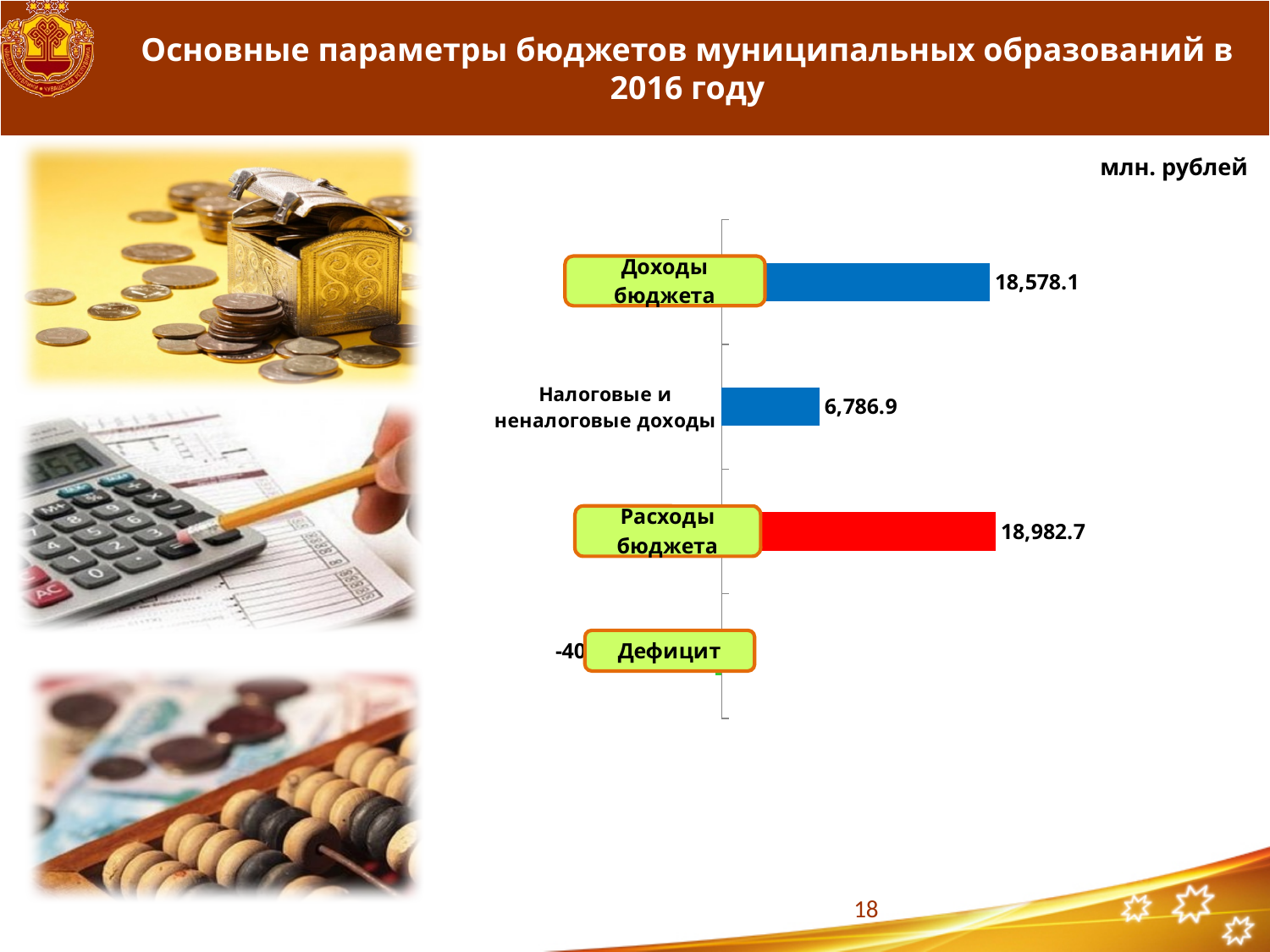
What is the value for Налоговые и неналоговые доходы? 6,786.9 What is the value for Расходы бюджета? 18,982.7 Which is larger, Доходы бюджета or Расходы бюджета? Расходы бюджета What is the value for Доходы бюджета? 18,578.1 Which category has the highest value? Расходы бюджета Which is larger, Доходы бюджета or Налоговые и неналоговые доходы? Доходы бюджета What is the difference between Расходы бюджета and Доходы бюджета? 404.6 What kind of chart is shown on the slide? Bar chart What colour is the bar for Расходы бюджета? Red How many categories are shown in the chart? 4 What is the difference between Доходы бюджета and Налоговые и неналоговые доходы? 11,791.2 What unit is indicated for the chart values? млн. рублей